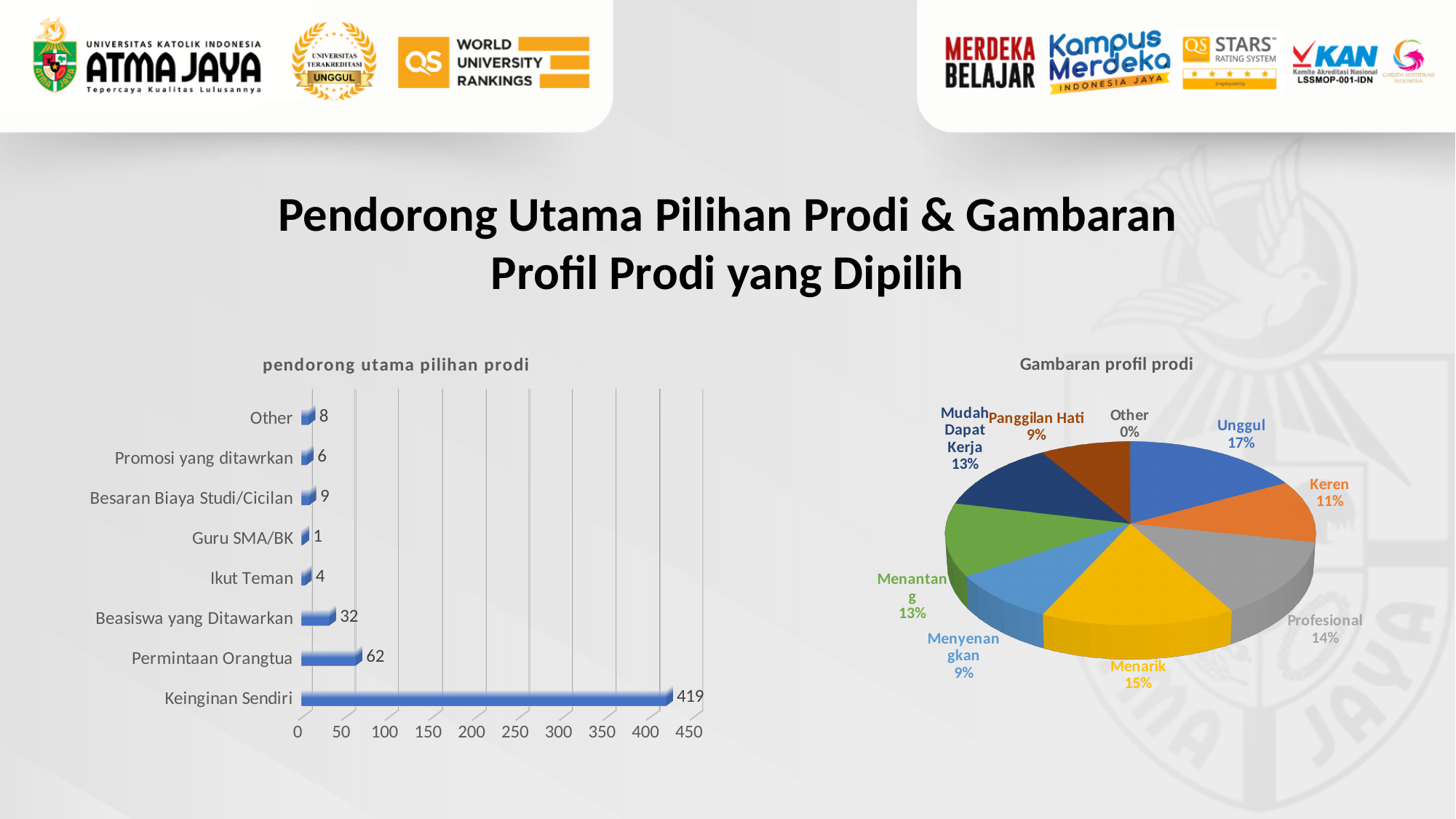
How many categories are shown in the 'pendorong utama pilihan prodi' chart? 8 In the 'pendorong utama pilihan prodi' chart, which is larger: Besaran Biaya Studi/Cicilan or Promosi yang ditawrkan? Besaran Biaya Studi/Cicilan In the 'pendorong utama pilihan prodi' chart, what is the value for Permintaan Orangtua? 62 In the 'pendorong utama pilihan prodi' chart, what is the value for Keinginan Sendiri? 419 In the 'Gambaran profil prodi' chart, which slice has the largest share? Unggul In the 'pendorong utama pilihan prodi' chart, which category has the highest value? Keinginan Sendiri In the 'pendorong utama pilihan prodi' chart, what is the difference between Permintaan Orangtua and Beasiswa yang Ditawarkan? 30 In the 'pendorong utama pilihan prodi' chart, which category has the lowest value? Guru SMA/BK In the 'Gambaran profil prodi' chart, what share does Unggul have? 17% What type of chart is 'pendorong utama pilihan prodi'? Bar chart What type of chart is 'Gambaran profil prodi'? Pie chart In the 'Gambaran profil prodi' chart, what share does Menarik have? 15%